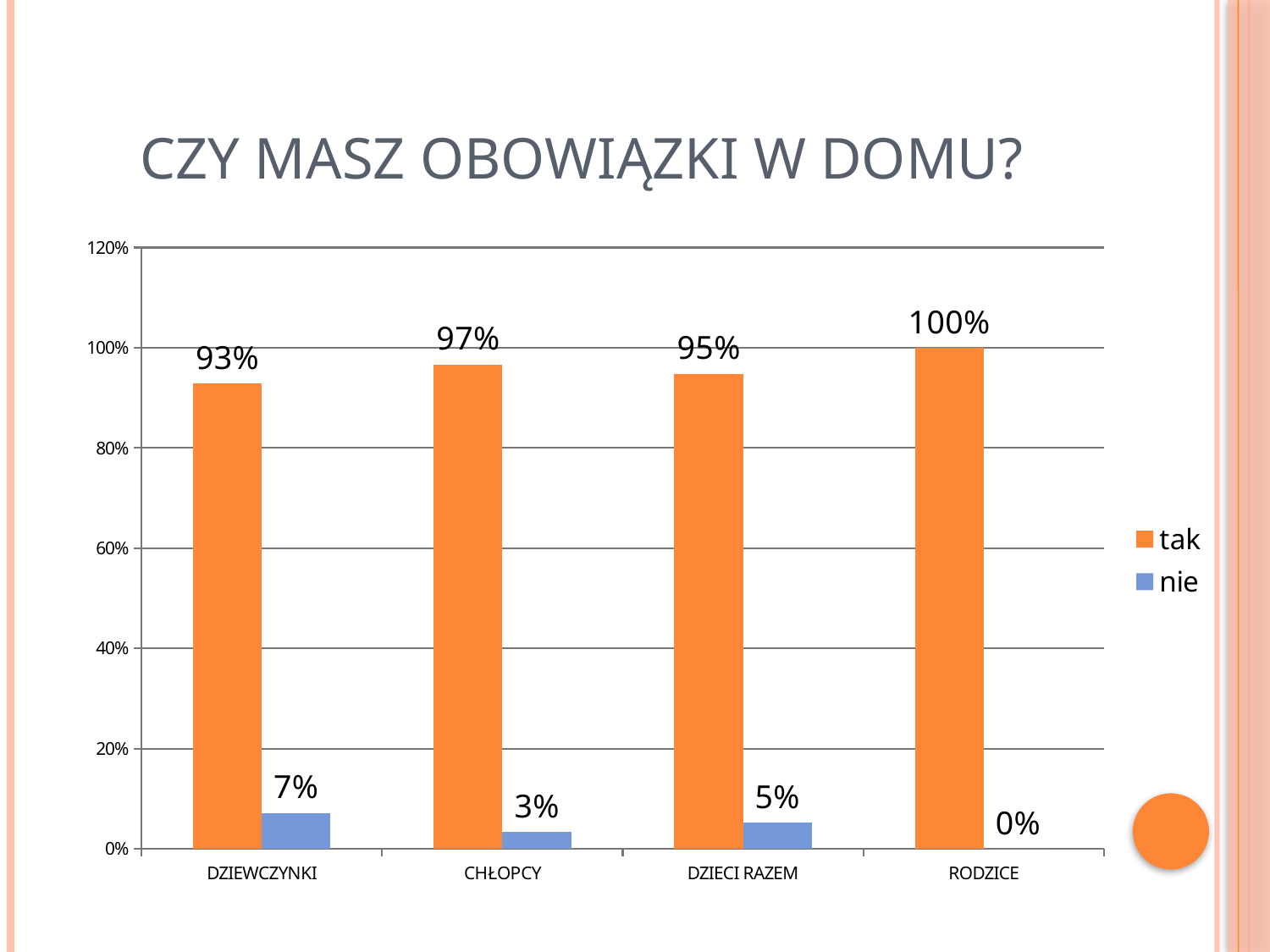
Which category has the highest 'nie' value? DZIEWCZYNKI What is the 'tak' value for RODZICE? 100% What is the 'nie' value for CHŁOPCY? 3% What is the 'tak' value for DZIEWCZYNKI? 93% How many categories are shown on the x axis? 4 Which is larger, the 'nie' value for DZIEWCZYNKI or for CHŁOPCY? DZIEWCZYNKI What kind of chart is shown on the slide? Bar chart How many series does the legend list? 2 What is the 'nie' value for DZIECI RAZEM? 5% Which category has the lowest 'tak' value? DZIEWCZYNKI Which category has the highest 'tak' value? RODZICE What is the difference between the 'tak' values for CHŁOPCY and DZIEWCZYNKI? 4%